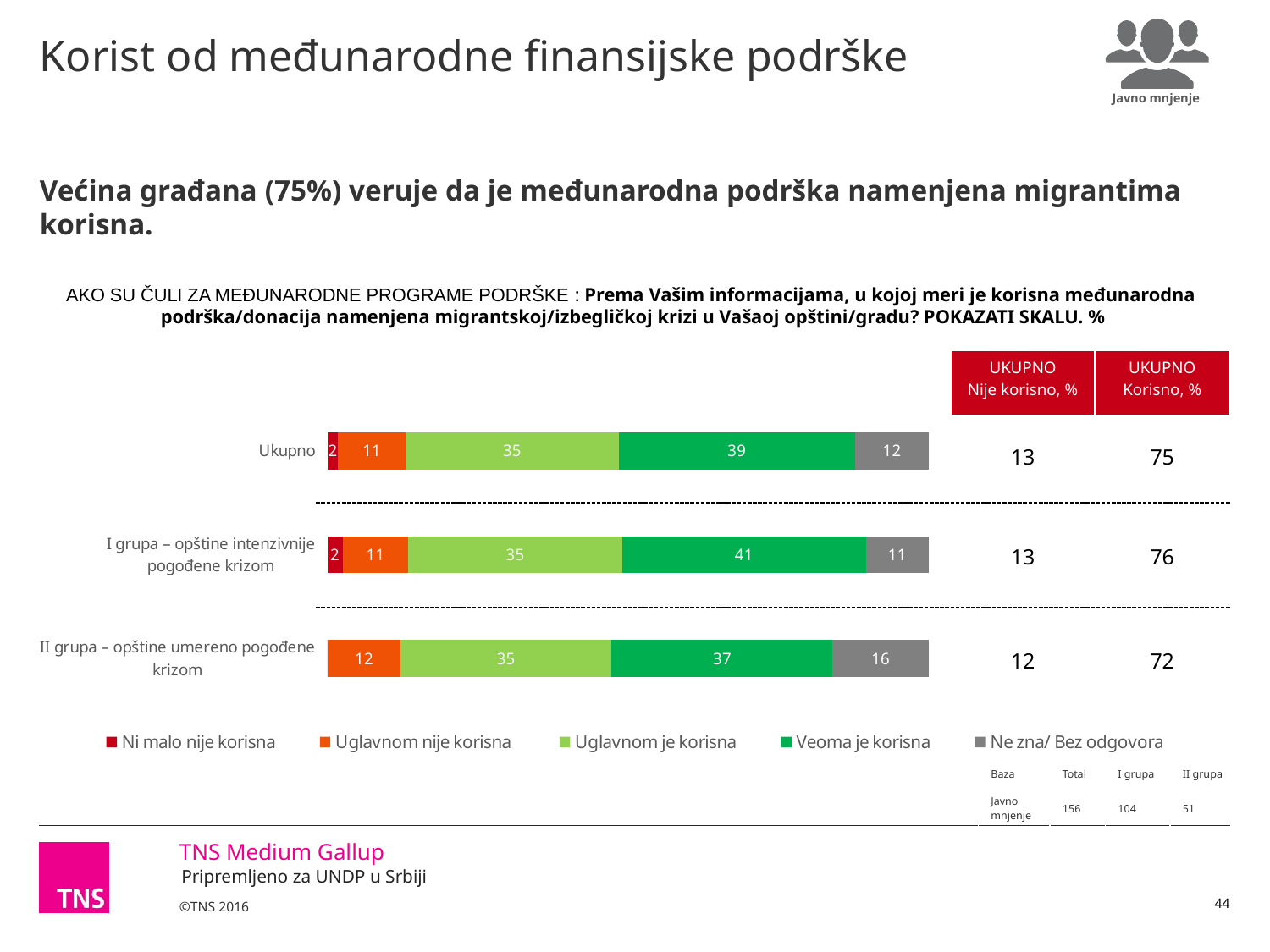
What is the value for "Uglavnom nije korisna" in the "II grupa – opštine umereno pogođene krizom" bar? 12 What is the value for "Veoma je korisna" in the "Ukupno" bar? 39 Which category has the lowest value for "Ne zna/ Bez odgovora"? I grupa – opštine intenzivnije pogođene krizom What is the value for "Uglavnom je korisna" in the "I grupa – opštine intenzivnije pogođene krizom" bar? 35 What is the value for "Ne zna/ Bez odgovora" in the "II grupa – opštine umereno pogođene krizom" bar? 16 Which is larger: the "Ne zna/ Bez odgovora" value for "Ukupno" or for "II grupa – opštine umereno pogođene krizom"? II grupa – opštine umereno pogođene krizom How many categories (bars) are plotted in the chart? 3 What kind of chart is shown on the slide? stacked bar chart How many series does the chart legend list? 5 What is the difference between the "Veoma je korisna" values for "I grupa" and "II grupa"? 4 Which category has the highest value for "Veoma je korisna"? I grupa – opštine intenzivnije pogođene krizom Which legend entry is shown in dark red? Ni malo nije korisna